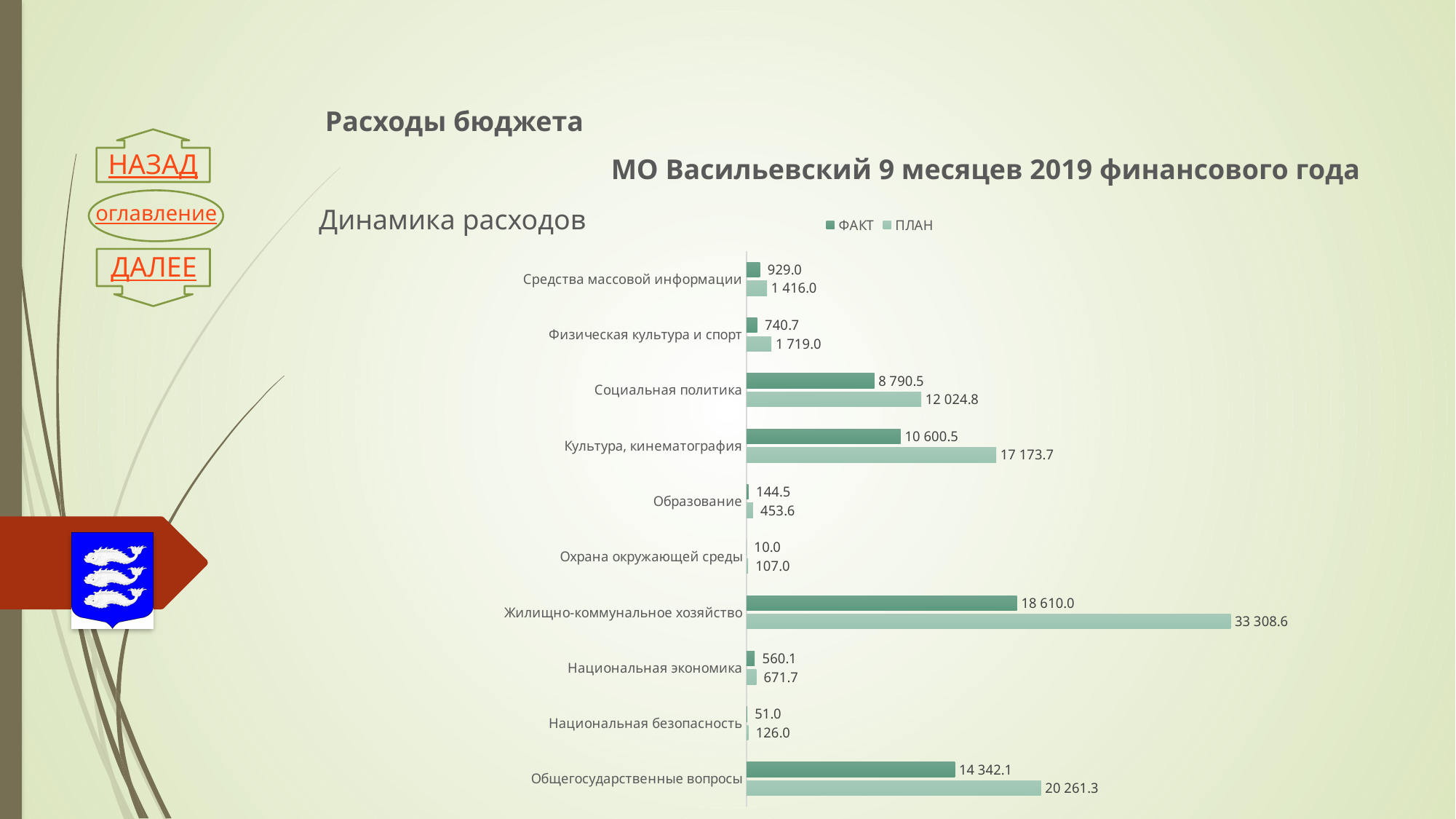
What is the ФАКТ value for Жилищно-коммунальное хозяйство? 18 610.0 What is the difference between the ПЛАН and ФАКТ values for Социальная политика? 3 234.3 How many categories are shown in the chart? 10 What is the title of the chart? Динамика расходов What is the ПЛАН value for Культура, кинематография? 17 173.7 How many series does the chart legend list? 2 Which category has the lowest ФАКТ value? Охрана окружающей среды What type of chart is shown on the slide? Bar chart Which category has the highest ПЛАН value? Жилищно-коммунальное хозяйство What is the ФАКТ value for Образование? 144.5 Which is larger: the ФАКТ value for Общегосударственные вопросы or the ФАКТ value for Культура, кинематография? Общегосударственные вопросы What is the ПЛАН value for Национальная безопасность? 126.0